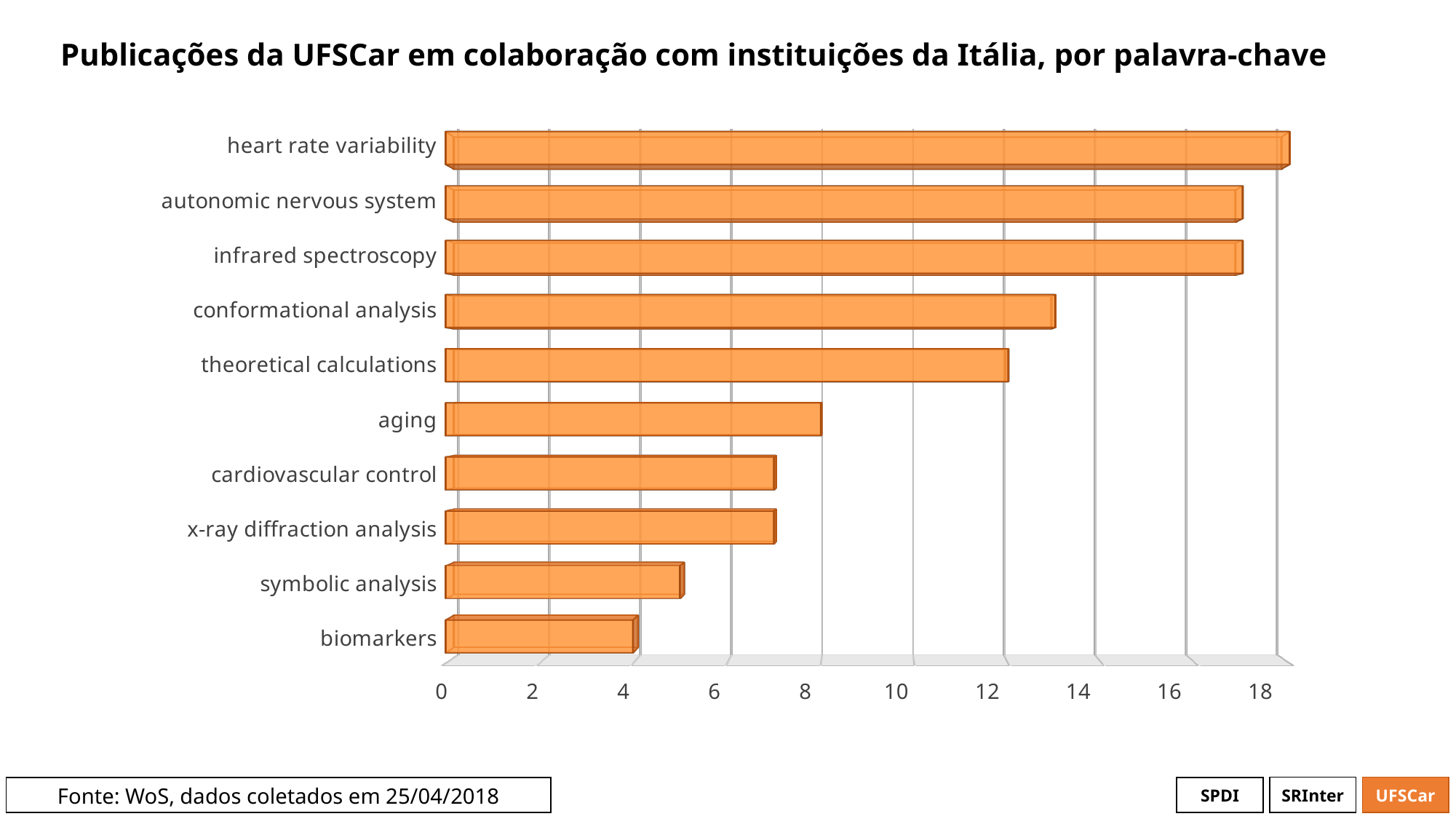
Is the value for biomarkers greater or less than 6? less Is the value for aging greater or less than 6? greater What kind of chart is shown on the slide? bar chart Which has more publications, aging or symbolic analysis? aging Is the value for cardiovascular control greater or less than 10? less Which keyword has the highest number of publications? heart rate variability What is the title of the chart? Publicações da UFSCar em colaboração com instituições da Itália, por palavra-chave Which has more publications, conformational analysis or theoretical calculations? conformational analysis How many keyword categories are plotted in the chart? 10 Which keyword has the lowest number of publications? biomarkers